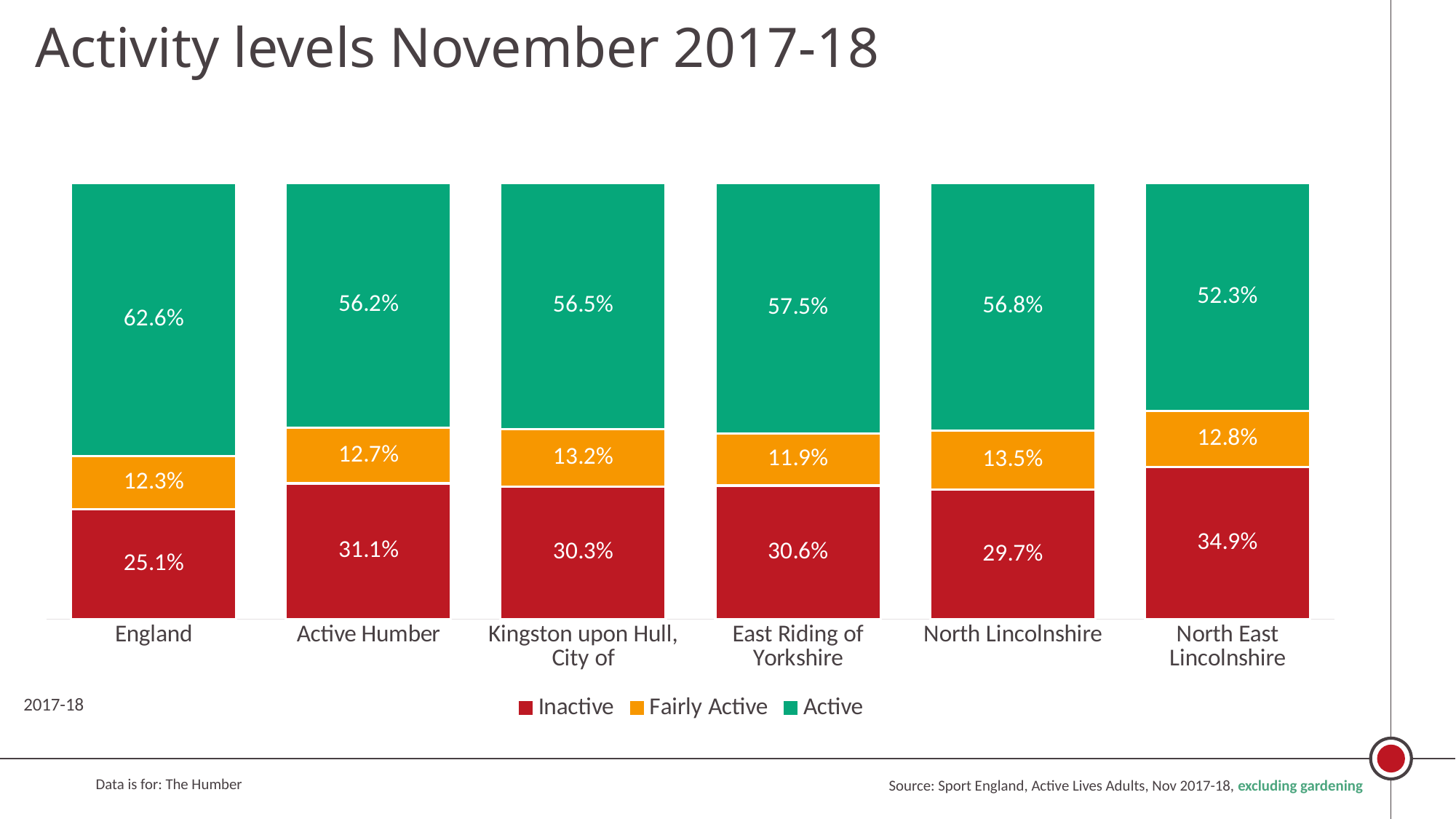
Which category has the highest Active value? England What is the Fairly Active value for North Lincolnshire? 13.5% How many categories are shown on the x axis? 6 How many series does the legend list? 3 What is the difference between the Active value for England and the Active value for North East Lincolnshire? 10.3 percentage points Which category has the highest Inactive value? North East Lincolnshire What is the Active value for England? 62.6% What is the Active value for East Riding of Yorkshire? 57.5% Which category has the lowest Fairly Active value? East Riding of Yorkshire Which category has the lowest Active value? North East Lincolnshire What is the Inactive value for North East Lincolnshire? 34.9% Which is larger: the Inactive value for Active Humber or the Inactive value for Kingston upon Hull, City of? Active Humber